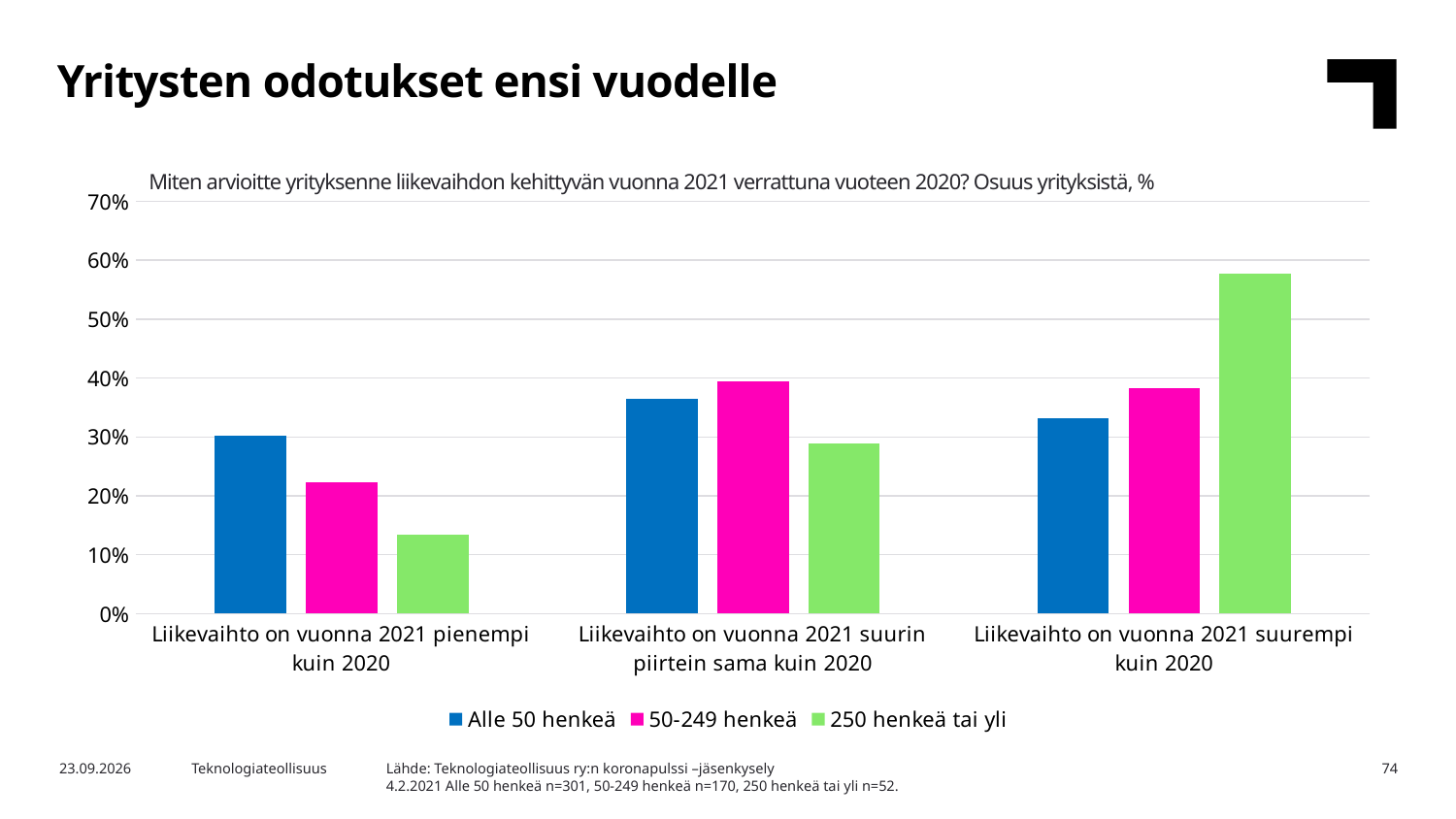
Which colour represents the series '50-249 henkeä' in the legend? magenta (pink) For 'Liikevaihto on vuonna 2021 pienempi kuin 2020', which is larger: the value for 'Alle 50 henkeä' or for '50-249 henkeä'? Alle 50 henkeä Is the value for '250 henkeä tai yli' in 'Liikevaihto on vuonna 2021 pienempi kuin 2020' greater or less than 20%? less For 'Liikevaihto on vuonna 2021 suurempi kuin 2020', which is larger: the value for 'Alle 50 henkeä' or for '250 henkeä tai yli'? 250 henkeä tai yli Which series has the lowest value for 'Liikevaihto on vuonna 2021 pienempi kuin 2020'? 250 henkeä tai yli Is the value for '250 henkeä tai yli' in 'Liikevaihto on vuonna 2021 suurempi kuin 2020' greater or less than 50%? greater Is the value for 'Alle 50 henkeä' in 'Liikevaihto on vuonna 2021 pienempi kuin 2020' greater or less than 40%? less How many series does the legend list? 3 Which series has the lowest value for 'Liikevaihto on vuonna 2021 suurin piirtein sama kuin 2020'? 250 henkeä tai yli What kind of chart is shown on the slide? bar chart How many categories are shown on the x axis? 3 Which series has the highest value for 'Liikevaihto on vuonna 2021 suurempi kuin 2020'? 250 henkeä tai yli